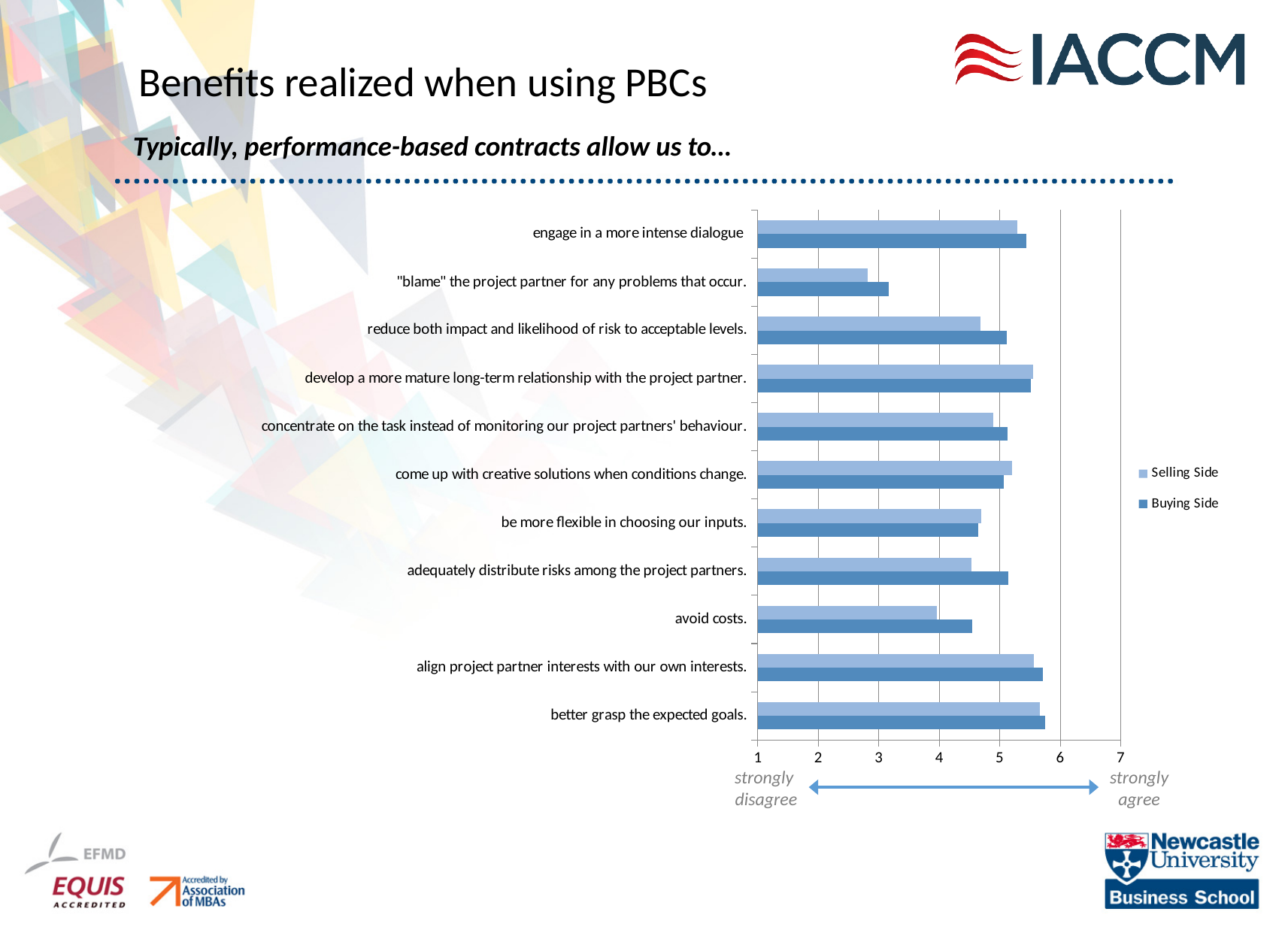
For "avoid costs", which series has the larger value, Selling Side or Buying Side? Buying Side How many series does the legend list? 2 Is the Selling Side value for "blame" the project partner for any problems that occur greater or less than 3? less How many categories (statements) are plotted on the chart? 11 What kind of chart is shown on the slide? bar chart Is the Buying Side value for "avoid costs" greater or less than 4? greater Is the Buying Side value for "engage in a more intense dialogue" greater or less than 5? greater Which statement has the lowest value for the Selling Side? "blame" the project partner for any problems that occur. Which statement has the lowest value for the Buying Side? "blame" the project partner for any problems that occur. For "adequately distribute risks among the project partners", which series has the larger value, Selling Side or Buying Side? Buying Side What are the two entries listed in the chart legend? Selling Side and Buying Side